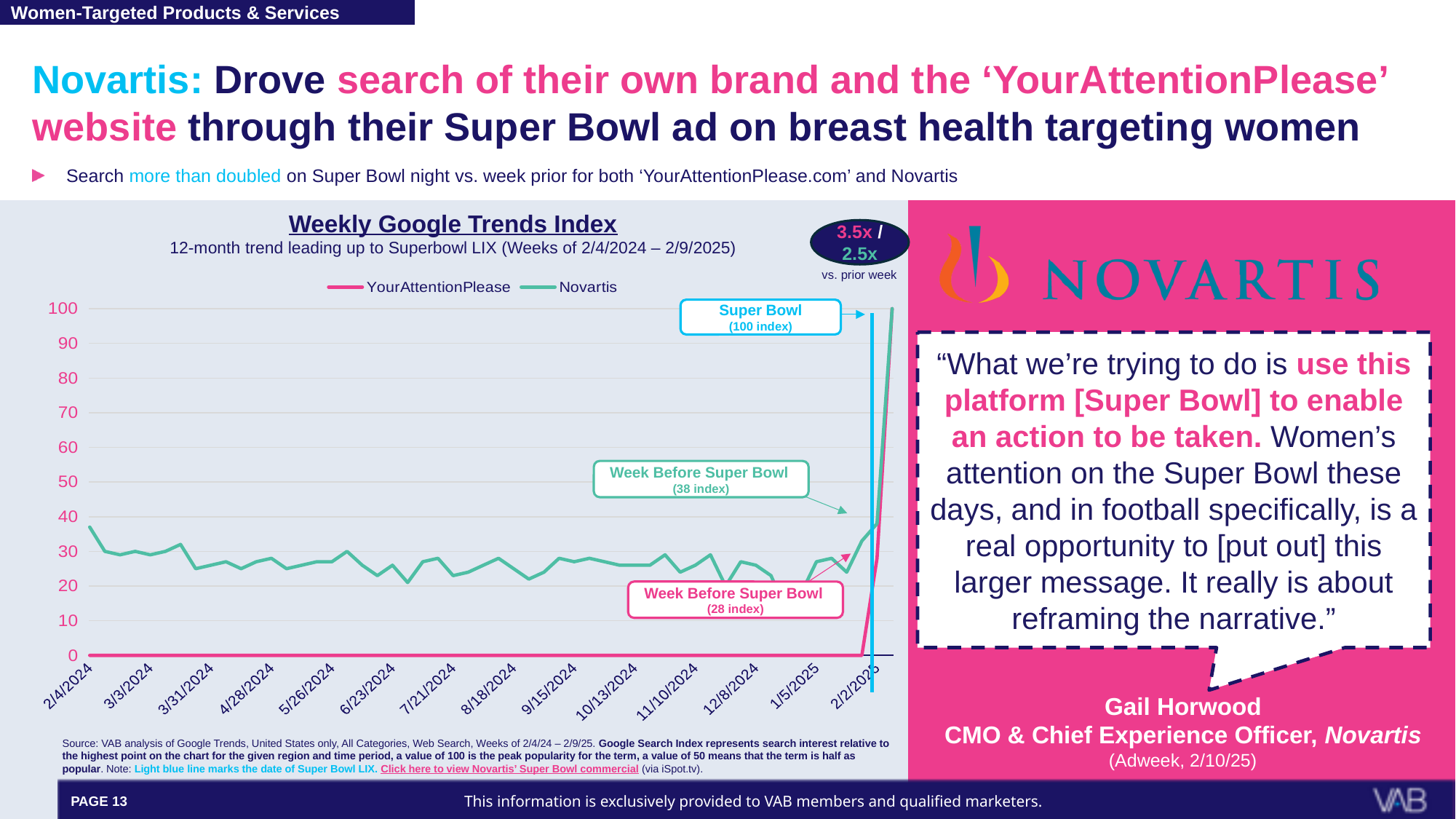
According to the chart note, what does the light blue vertical line mark? The date of Super Bowl LIX What index value is labeled for Novartis in the week before the Super Bowl? 38 index Is the YourAttentionPlease index value for the week of 6/23/2024 greater or less than 10? less What index value is labeled for the Super Bowl week on the Weekly Google Trends Index chart? 100 index What is the difference between the Novartis and YourAttentionPlease index values in the week before the Super Bowl? 10 What index value is labeled for YourAttentionPlease in the week before the Super Bowl? 28 index Is the Novartis index value for the week of 2/4/2024 greater or less than 30? greater How many series does the legend of the Weekly Google Trends Index chart list? 2 What are the two series named in the legend of the Weekly Google Trends Index chart? YourAttentionPlease and Novartis Is the Novartis index value for the week of 7/21/2024 greater or less than 40? less In the week before the Super Bowl, which series had the higher index value, Novartis or YourAttentionPlease? Novartis What kind of chart is the Weekly Google Trends Index chart? line chart